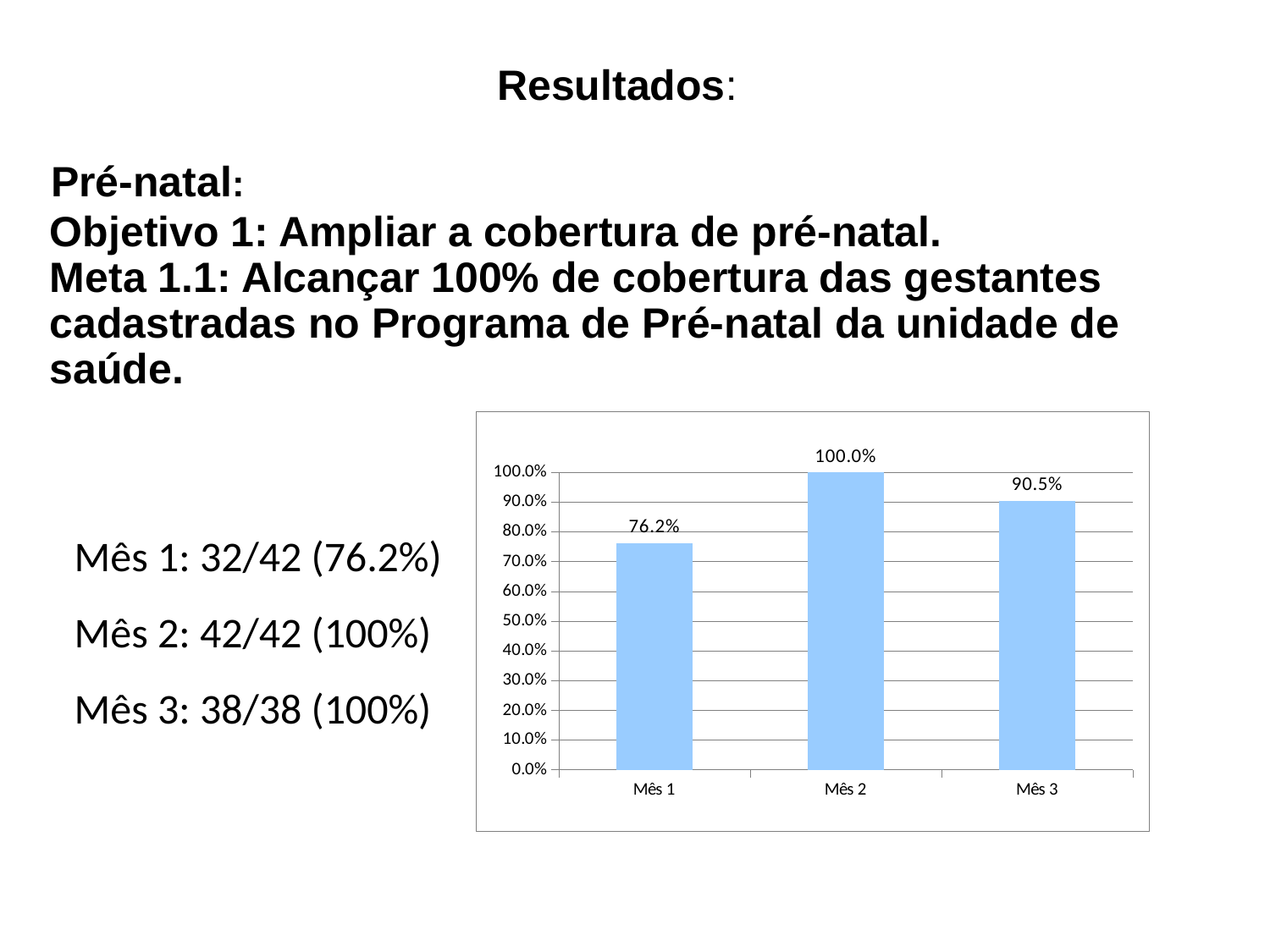
What is the difference between the values for Mês 3 and Mês 1 in the chart? 14.3% What is the value shown for Mês 1 in the chart? 76.2% Which is larger in the chart, the value for Mês 3 or the value for Mês 1? Mês 3 What kind of chart is shown on the slide? bar chart What is the value shown for Mês 3 in the chart? 90.5% Is the value for Mês 1 in the chart greater or less than 80.0%? less Which month has the highest value in the chart? Mês 2 What colour are the bars in the chart? light blue How many months (categories) are plotted in the chart? 3 Which month has the lowest value in the chart? Mês 1 What is the value shown for Mês 2 in the chart? 100.0% What is the difference between the values for Mês 2 and Mês 1 in the chart? 23.8%